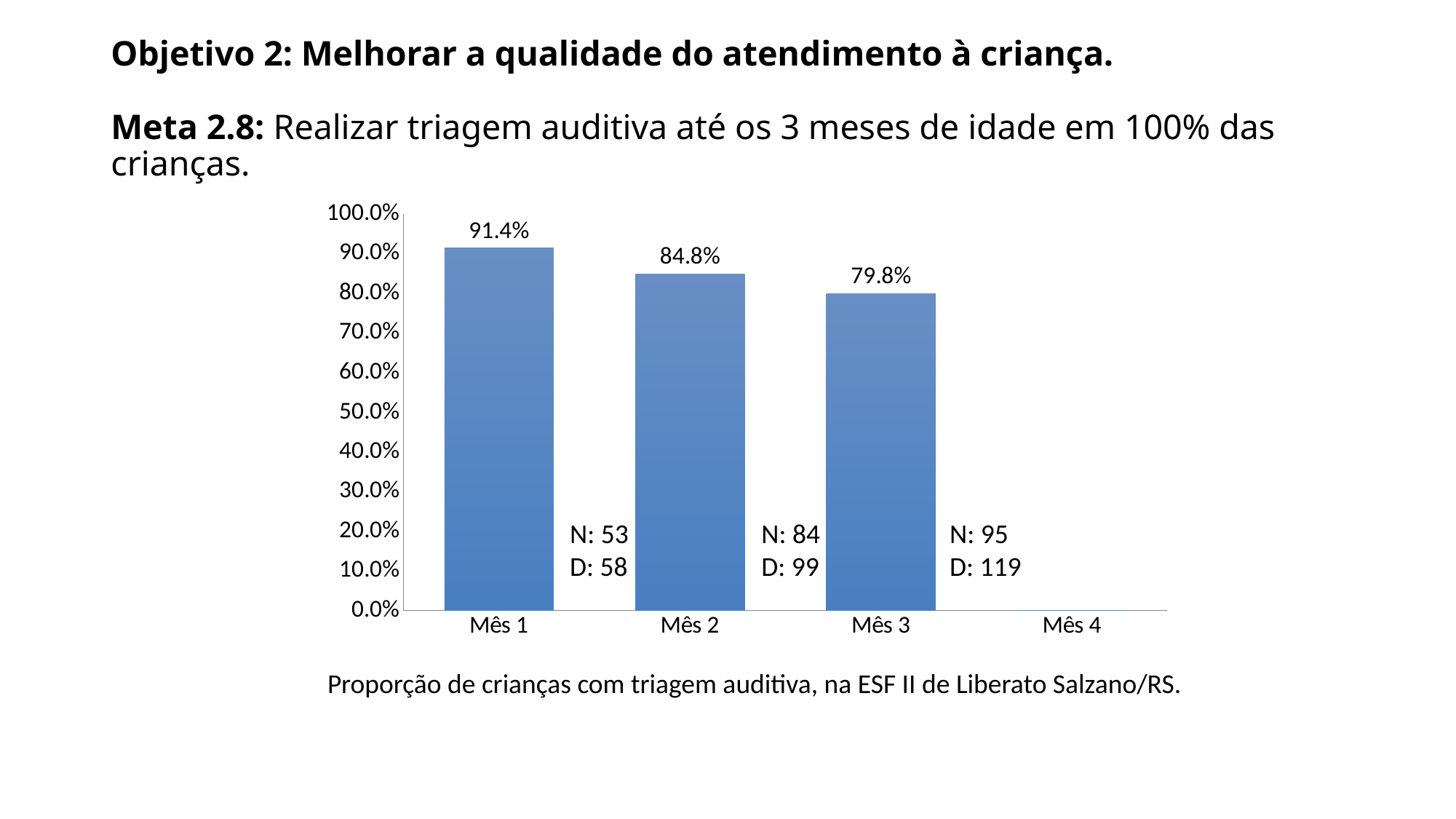
What is the difference between the values for Mês 1 and Mês 2? 6.6% What is the value for Mês 1? 91.4% Which month has the highest value among the bars shown? Mês 1 Which is larger, the value for Mês 2 or the value for Mês 3? Mês 2 Do the values rise or fall from Mês 1 to Mês 3? Fall What kind of chart is shown on the slide? Bar chart Which of the labelled bars has the lowest value? Mês 3 What is the difference between the values for Mês 1 and Mês 3? 11.6% What is the value for Mês 2? 84.8% How many categories are shown on the x axis? 4 What is the value for Mês 3? 79.8% Is the value for Mês 2 greater or less than 80.0%? greater